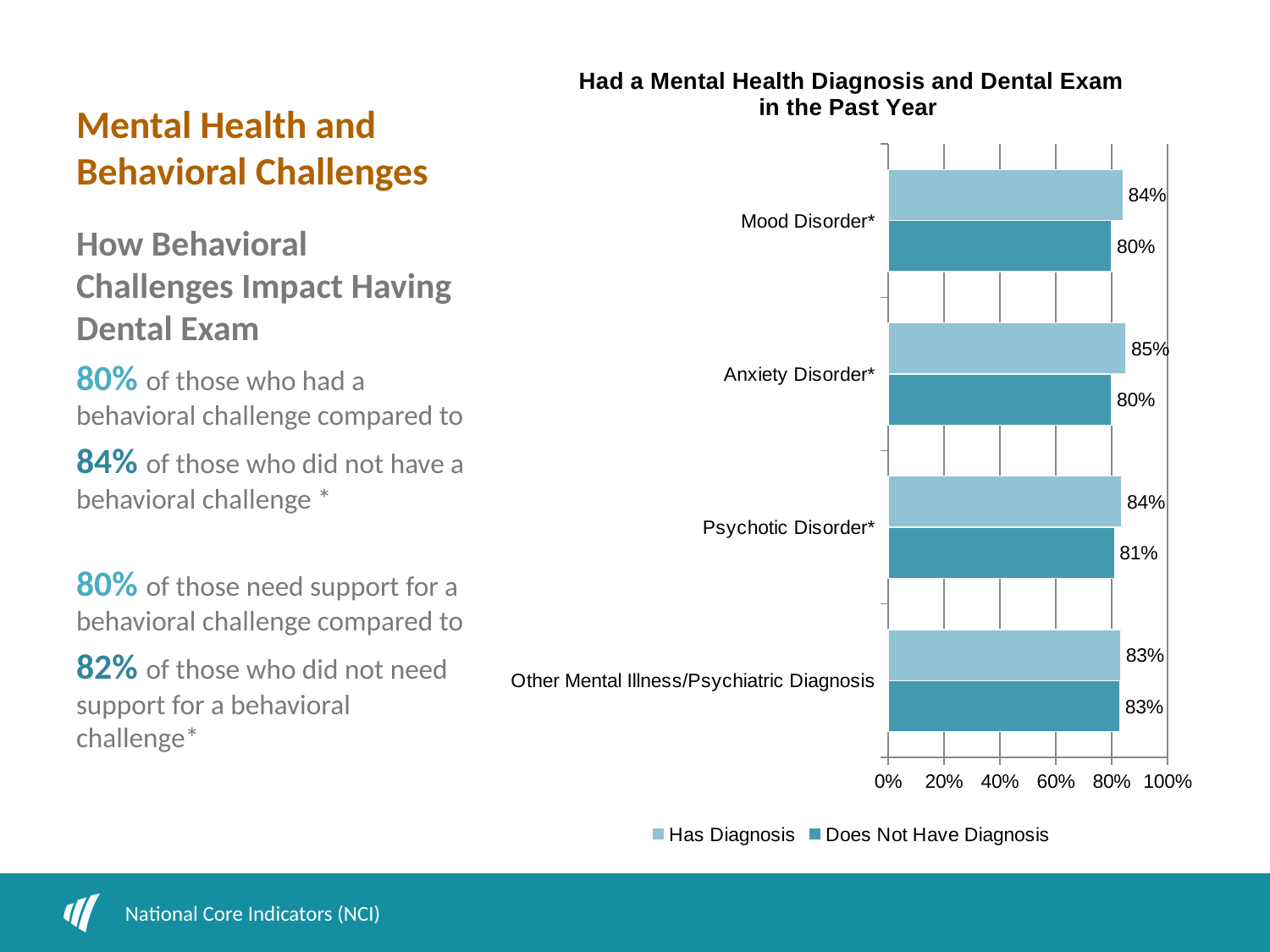
What is the value for Has Diagnosis for Mood Disorder*? 84% How many series does the legend list? 2 What is the difference between the Has Diagnosis and Does Not Have Diagnosis values for Anxiety Disorder*? 5% What is the title of the chart? Had a Mental Health Diagnosis and Dental Exam in the Past Year What is the value for Does Not Have Diagnosis for Psychotic Disorder*? 81% What is the value for Has Diagnosis for Other Mental Illness/Psychiatric Diagnosis? 83% For Psychotic Disorder*, which is larger: Has Diagnosis or Does Not Have Diagnosis? Has Diagnosis What is the value for Does Not Have Diagnosis for Anxiety Disorder*? 80% Which category has the highest Has Diagnosis value? Anxiety Disorder* What is the difference between the Has Diagnosis and Does Not Have Diagnosis values for Mood Disorder*? 4% How many categories are shown on the chart? 4 What kind of chart is shown on the slide? Bar chart